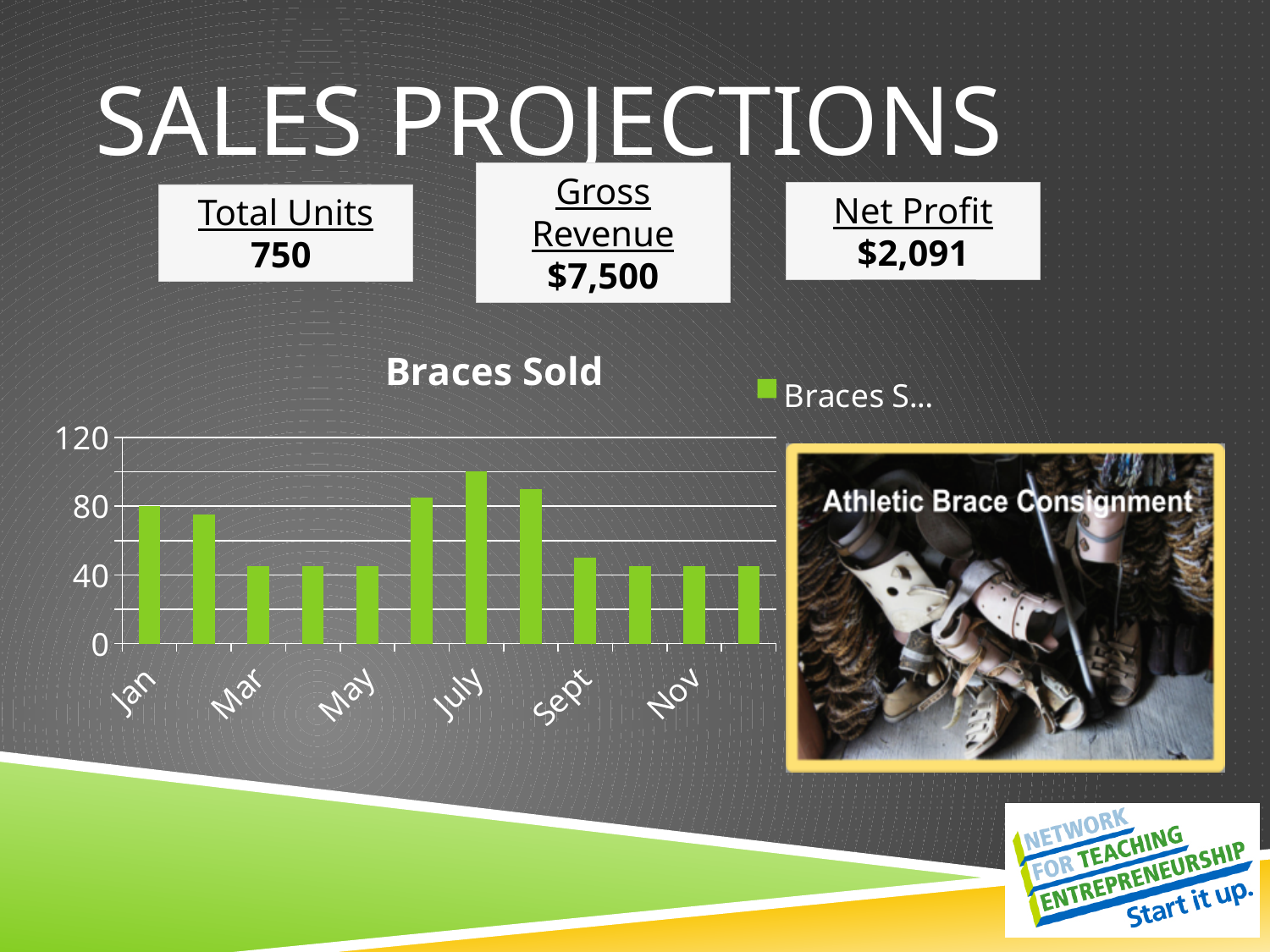
How many series does the legend of the Braces Sold chart list? 1 Which is larger, the value for July or the value for Sept? July Is the value for Nov greater or less than 80? less Which month has the highest number of braces sold? July Do the values rise or fall from Jan to Mar? fall Is the value for Jan greater or less than 40? greater What is the title of the chart? Braces Sold Is the value for Mar greater or less than 80? less How many bars are plotted in the Braces Sold chart? 12 Which is larger, the value for Jan or the value for Mar? Jan What kind of chart is shown on the slide? bar chart